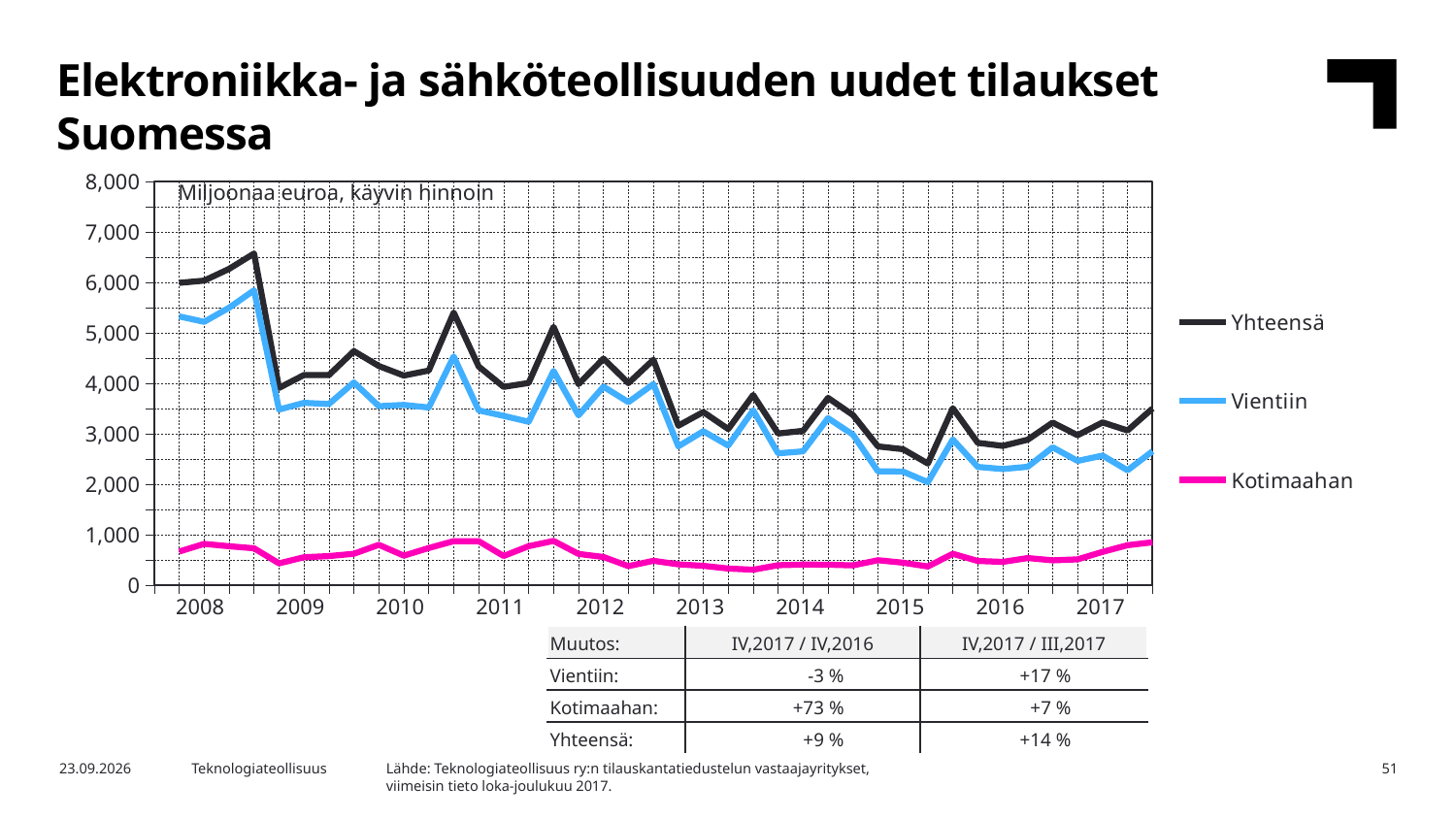
What kind of chart is shown on the slide? line chart Which series is larger in 2016, Vientiin or Kotimaahan? Vientiin How many series does the legend list? 3 What are the three series named in the legend? Yhteensä, Vientiin, Kotimaahan What unit is stated in the label inside the chart area? Miljoonaa euroa, käyvin hinnoin Which series has the highest values throughout the chart? Yhteensä Which series has the lowest values throughout the chart? Kotimaahan Is the value for Vientiin at the start of 2008 greater or less than 5,000? greater Is the value for Kotimaahan in 2017 greater or less than 1,000? less Is the peak value of Yhteensä in 2008 greater or less than 6,000? greater How many years are labelled on the x axis? 10 Does the Yhteensä series overall rise or fall from 2008 to 2017? fall